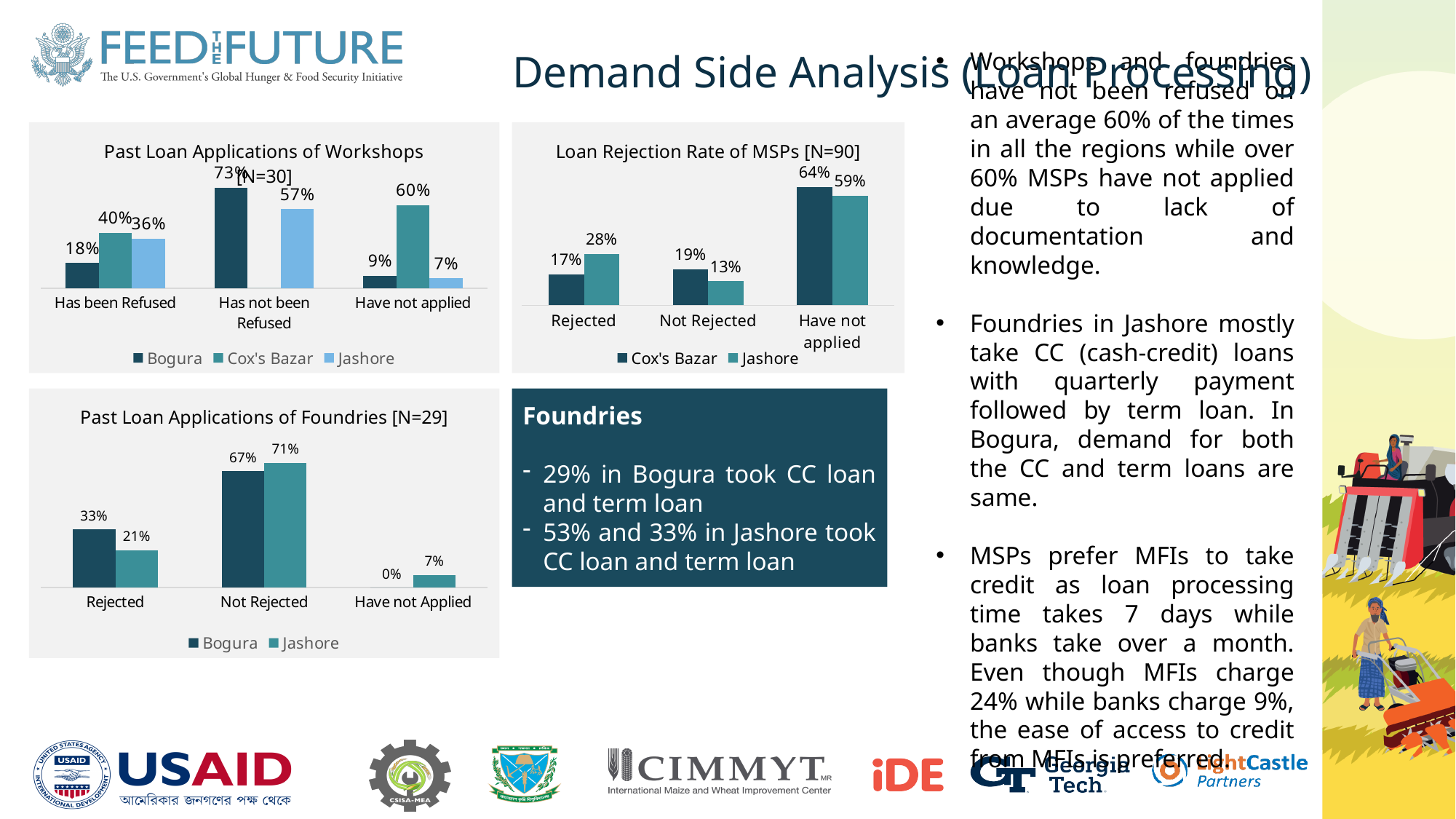
In the 'Past Loan Applications of Workshops' chart, what is the value for Cox's Bazar in the 'Have not applied' category? 60% What type of chart is the 'Past Loan Applications of Foundries' chart? Bar chart In the 'Loan Rejection Rate of MSPs' chart, which is larger in the 'Not Rejected' category, Cox's Bazar or Jashore? Cox's Bazar In the 'Past Loan Applications of Foundries' chart, which category has the lowest value for Bogura? Have not Applied In the 'Past Loan Applications of Workshops' chart, what is the value for Bogura in the 'Has been Refused' category? 18% In the 'Past Loan Applications of Foundries' chart, what is the difference between Bogura and Jashore in the 'Rejected' category? 12% In the 'Loan Rejection Rate of MSPs' chart, which category has the highest value for Cox's Bazar? Have not applied In the 'Past Loan Applications of Workshops' chart, what is the difference between Bogura and Jashore in the 'Has not been Refused' category? 16% In the 'Loan Rejection Rate of MSPs' chart, what is the value for Jashore in the 'Rejected' category? 28% In the 'Past Loan Applications of Foundries' chart, what is the value for Jashore in the 'Not Rejected' category? 71% In the 'Loan Rejection Rate of MSPs' chart, how many categories are shown on the x axis? 3 In the 'Past Loan Applications of Workshops' chart, how many series does the legend list? 3